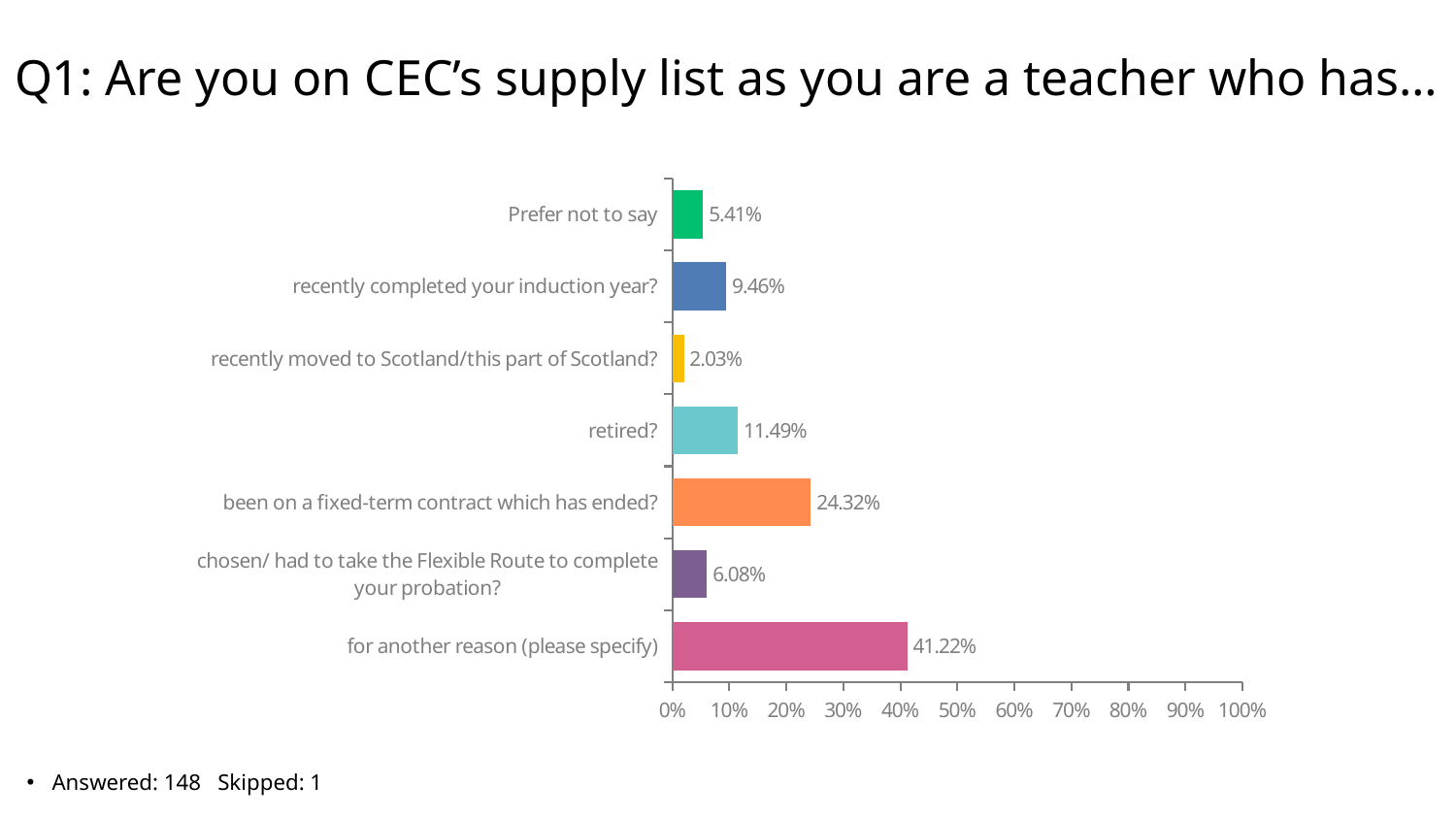
What is the value for "been on a fixed-term contract which has ended?" 24.32% What is the difference between "for another reason (please specify)" and "been on a fixed-term contract which has ended?" 16.90% Is the value for "for another reason (please specify)" greater or less than 40%? greater What percentage chose "Prefer not to say"? 5.41% How many respondents answered the question according to the slide? 148 Which category has the highest value? for another reason (please specify) What kind of chart is shown on the slide? bar chart Which category has the lowest value? recently moved to Scotland/this part of Scotland? What is the difference between "retired?" and "recently completed your induction year?" 2.03% How many categories are shown in the chart? 7 Which is larger: "recently completed your induction year?" or "chosen/ had to take the Flexible Route to complete your probation?" recently completed your induction year? What percentage of respondents answered "retired?" 11.49%